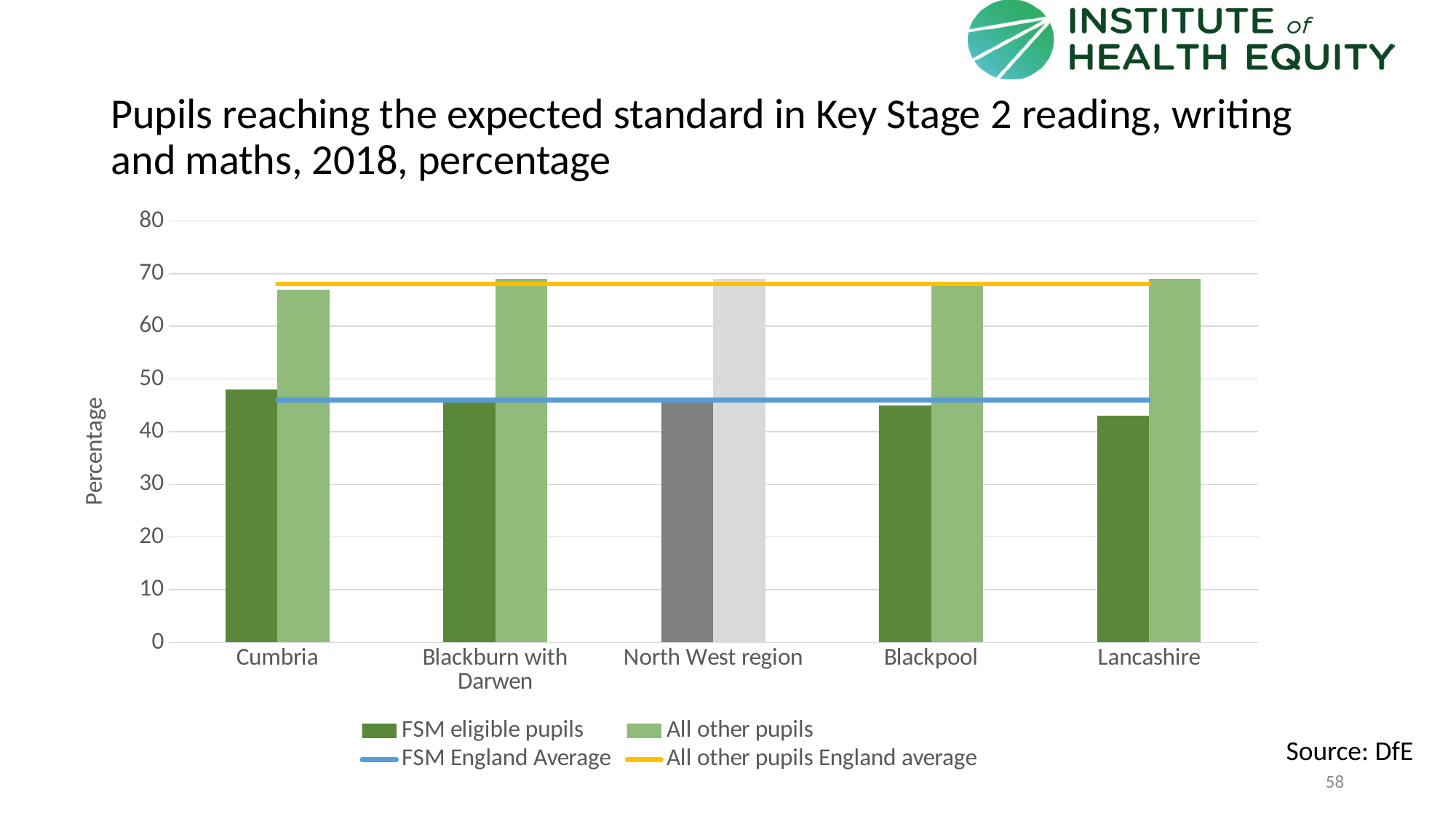
Which area has the lowest value for FSM eligible pupils? Lancashire Which is larger: the FSM eligible pupils value for Cumbria or for Lancashire? Cumbria Is the value for FSM eligible pupils in Lancashire greater or less than 50? less Is the value for All other pupils in Cumbria greater or less than 60? greater What kind of chart is shown on the slide? combination bar and line chart How many areas (categories) are shown along the x axis? 5 What is the label on the vertical axis? Percentage Which area has the highest value for FSM eligible pupils? Cumbria Is the value for All other pupils in Lancashire greater or less than 70? less How many entries does the legend list? 4 In Blackpool, which is larger: the value for FSM eligible pupils or for All other pupils? All other pupils